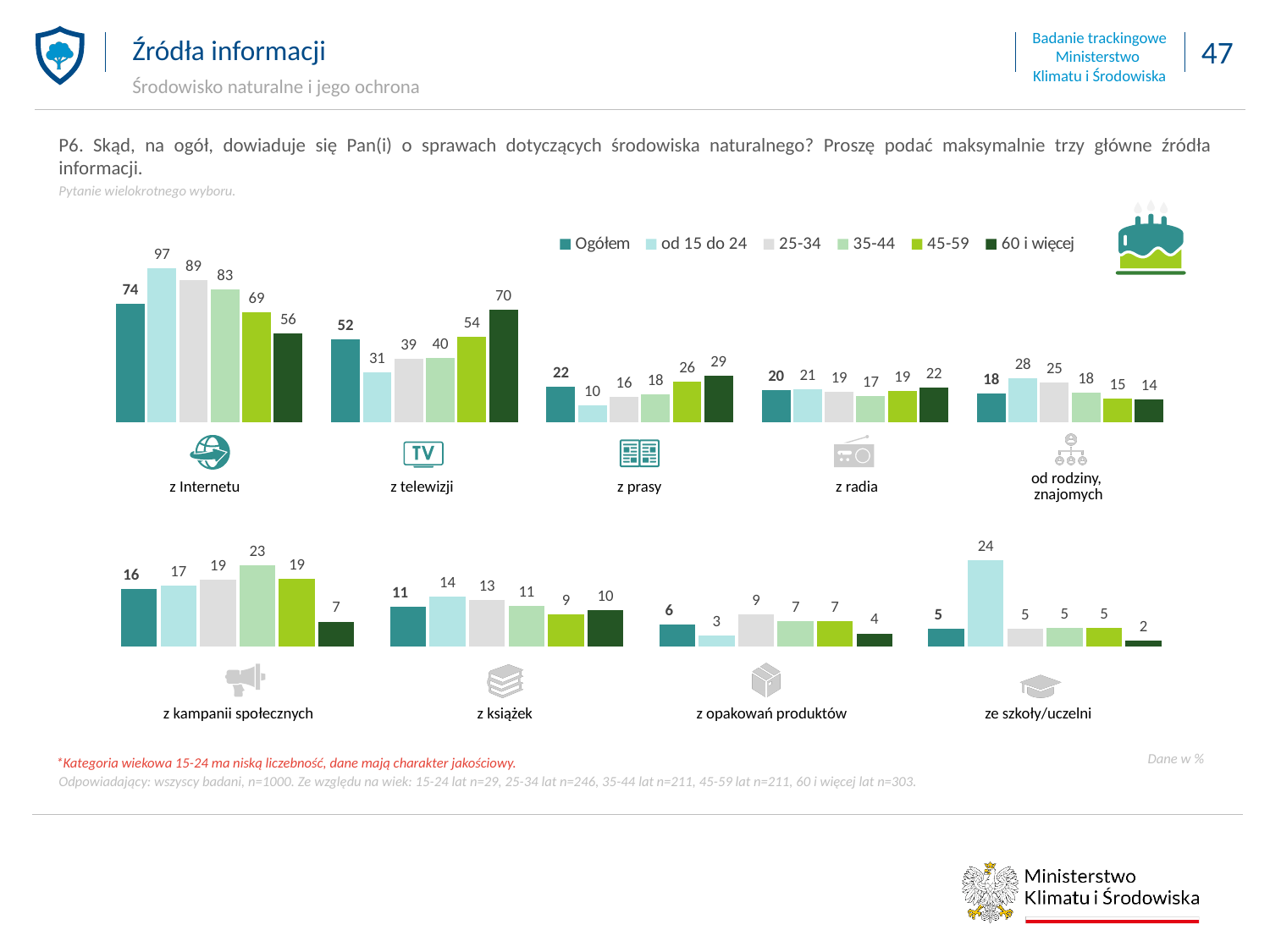
Which age group has the highest value in the 'z prasy' category? 60 i więcej How many series does the legend list? 6 How many source categories are shown on the slide? 9 What is the value for 'od 15 do 24' in the 'ze szkoły/uczelni' category? 24 What is the value for '35-44' in the 'z kampanii społecznych' category? 23 What is the difference between the 'od 15 do 24' and '60 i więcej' values in the 'z Internetu' category? 41 Which category has the lowest 'Ogółem' value? ze szkoły/uczelni What is the value for 'Ogółem' in the 'z Internetu' category? 74 In the 'z telewizji' category, which is larger: the value for 'od 15 do 24' or the value for '45-59'? 45-59 What is the value for '60 i więcej' in the 'z telewizji' category? 70 Which category has the highest 'Ogółem' value? z Internetu What kind of chart is shown on the slide? bar chart